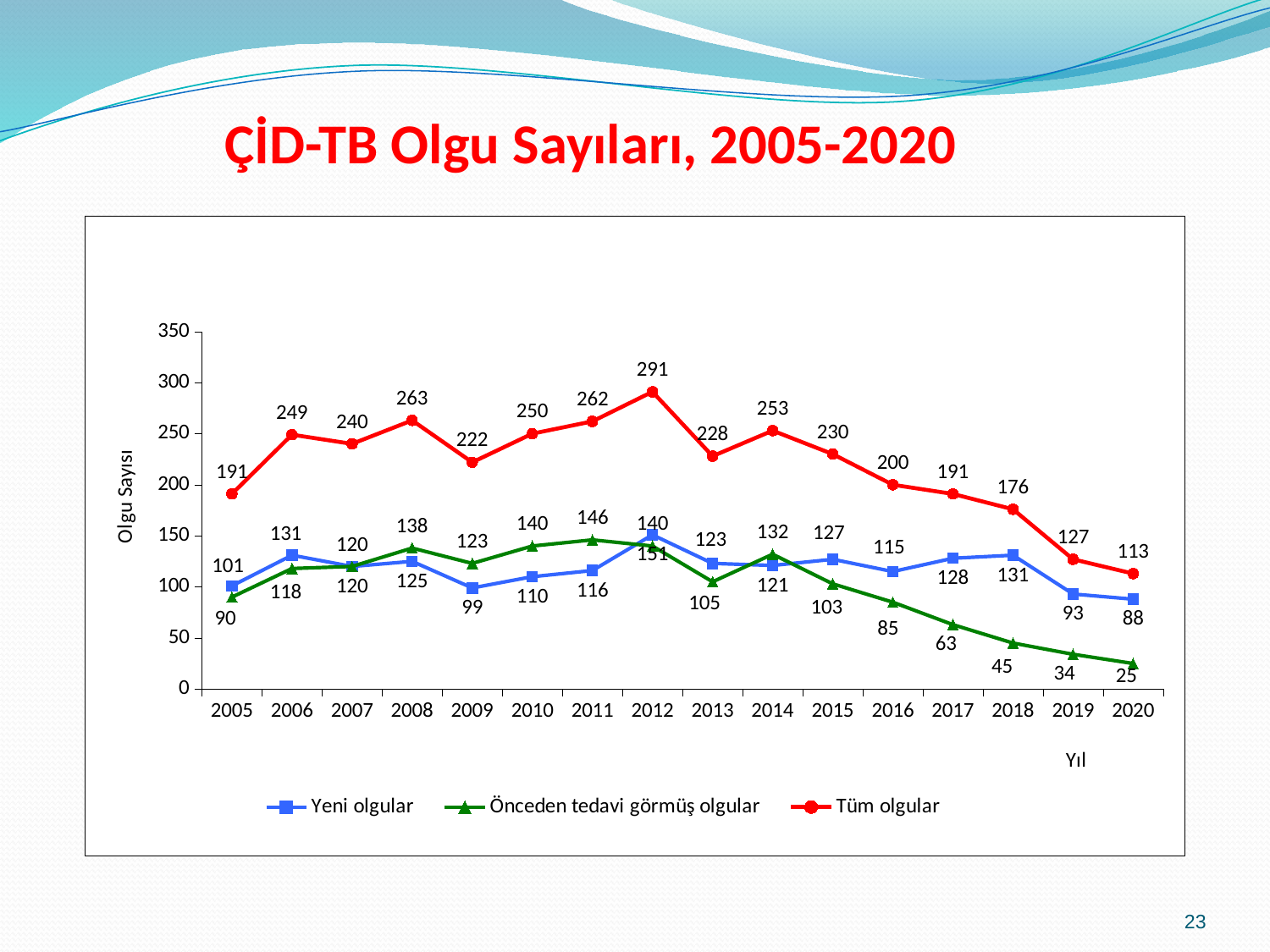
What is the value of Yeni olgular in 2009? 99 What is the difference between Tüm olgular in 2012 and in 2020? 178 What is the title of the chart? ÇİD-TB Olgu Sayıları, 2005-2020 In which year is Önceden tedavi görmüş olgular lowest? 2020 How many series does the legend list? 3 In which year is Tüm olgular highest? 2012 What is the value of Tüm olgular in 2012? 291 Which is larger in 2011: Yeni olgular or Önceden tedavi görmüş olgular? Önceden tedavi görmüş olgular What type of chart is shown on the slide? line chart Does Önceden tedavi görmüş olgular rise or fall from 2014 to 2020? fall What is the value of Önceden tedavi görmüş olgular in 2020? 25 How many years are plotted on the x axis? 16